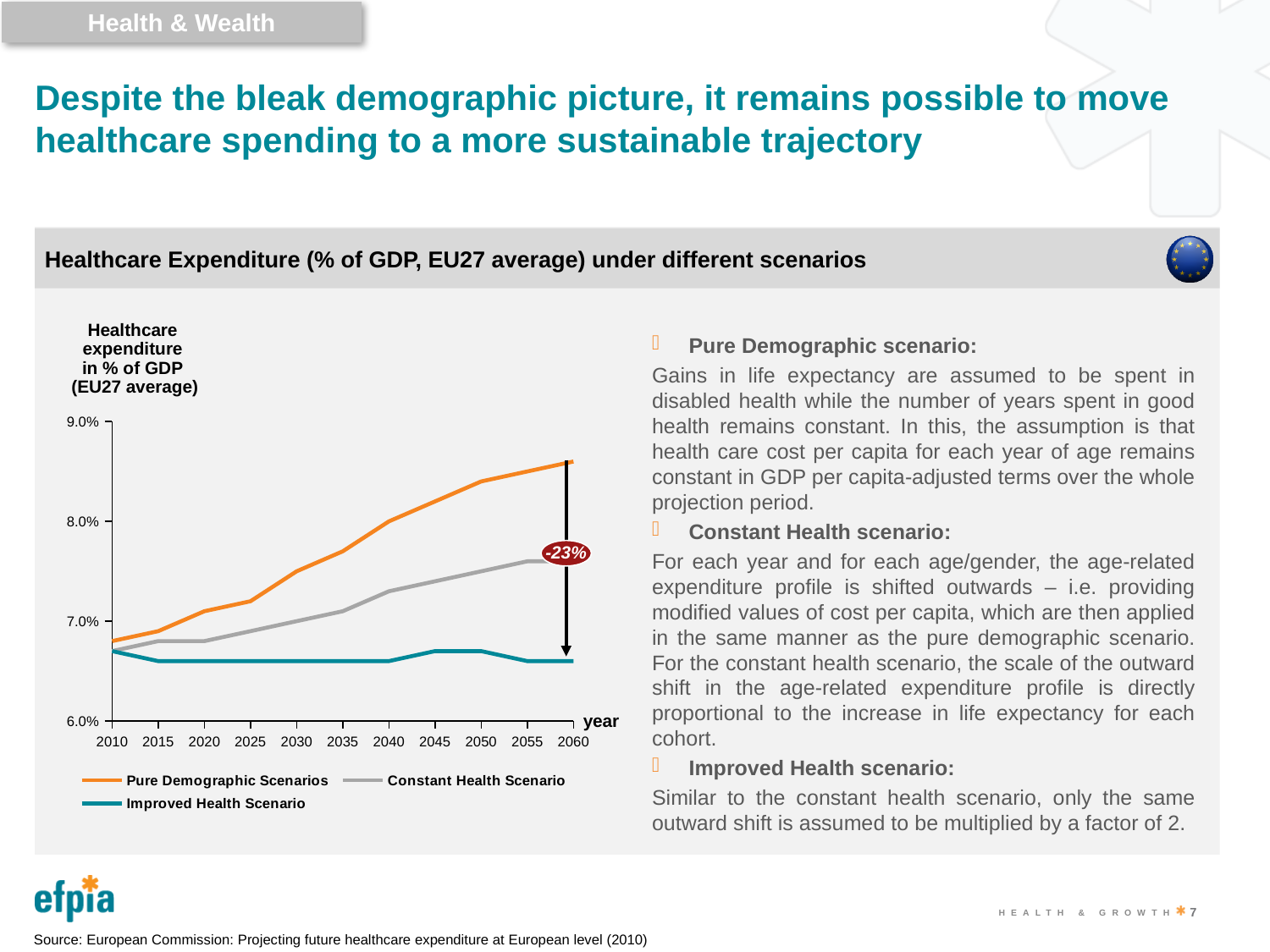
What kind of chart is shown on the slide? line chart Is the value for the Pure Demographic Scenarios in 2060 greater or less than 8.0%? greater Is the value for the Improved Health Scenario in 2060 greater or less than 7.0%? less Does the Pure Demographic Scenarios line rise or fall from 2010 to 2060? rise Is the value for the Constant Health Scenario in 2060 greater or less than 8.0%? less What percentage change is shown in the red callout next to the arrow at 2060? -23% What is the label on the x axis of the chart? year How many years are marked on the x axis of the chart? 11 How many series does the chart's legend list? 3 Which scenario has the highest healthcare expenditure in 2060? Pure Demographic Scenarios Which scenario has the lowest healthcare expenditure in 2060? Improved Health Scenario In 2040, which is larger: the Pure Demographic Scenarios value or the Constant Health Scenario value? Pure Demographic Scenarios